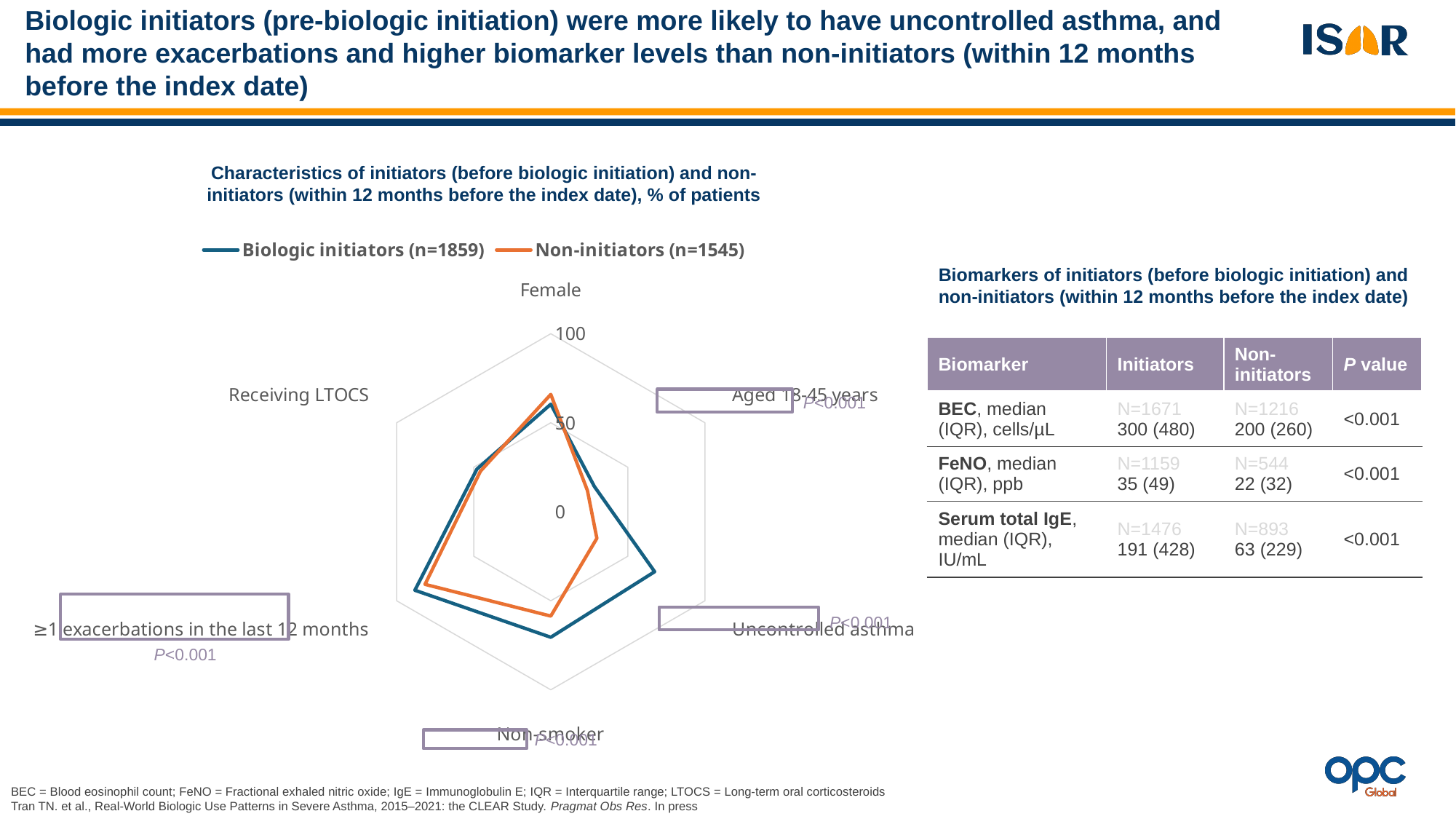
How many categories (axes) does the radar chart have? 6 What are the two series named in the chart legend? Biologic initiators (n=1859) and Non-initiators (n=1545) How many series does the chart legend list? 2 Is the value for ≥1 exacerbations in the last 12 months among Non-initiators greater or less than 50? greater Is the value for Uncontrolled asthma among Non-initiators greater or less than 50? less What is the maximum value shown on the radar chart's axis scale? 100 Is the value for Aged 18-45 years among Biologic initiators greater or less than 50? less For Uncontrolled asthma, which series has the larger value, Biologic initiators or Non-initiators? Biologic initiators What kind of chart is shown on the slide? Radar chart Which category has the highest value for Biologic initiators? ≥1 exacerbations in the last 12 months Which category has the lowest value for Biologic initiators? Aged 18-45 years